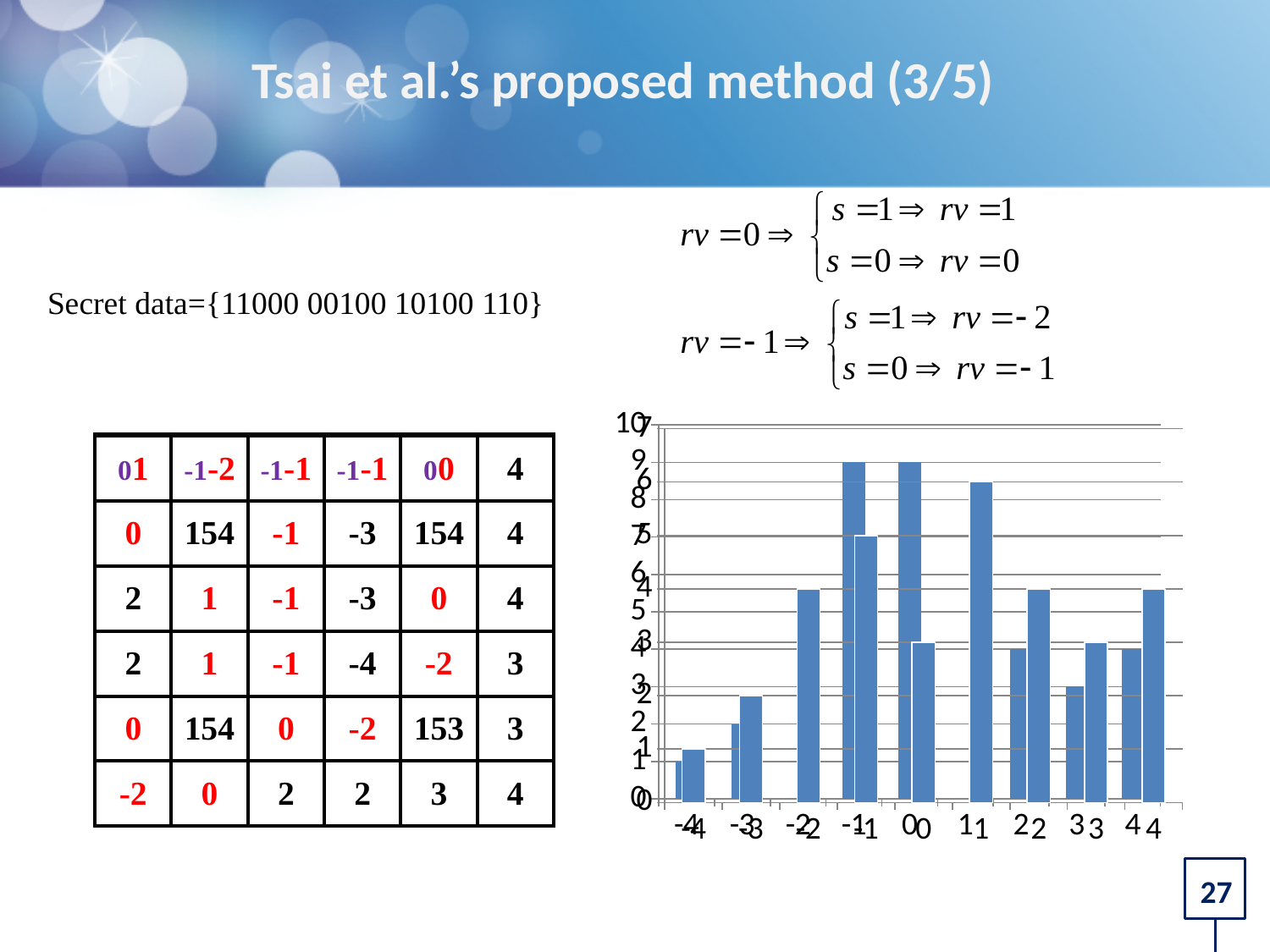
What kind of chart is shown on the right side of the slide? bar chart Are the bars at x = -1 taller or shorter than the bars at x = -4? taller Which x-axis category has the shortest bars in the bar chart? -4 How many distinct x-axis categories does the bar chart show? 9 What is the lowest x-axis label on the bar chart? -4 What is the highest x-axis label on the bar chart? 4